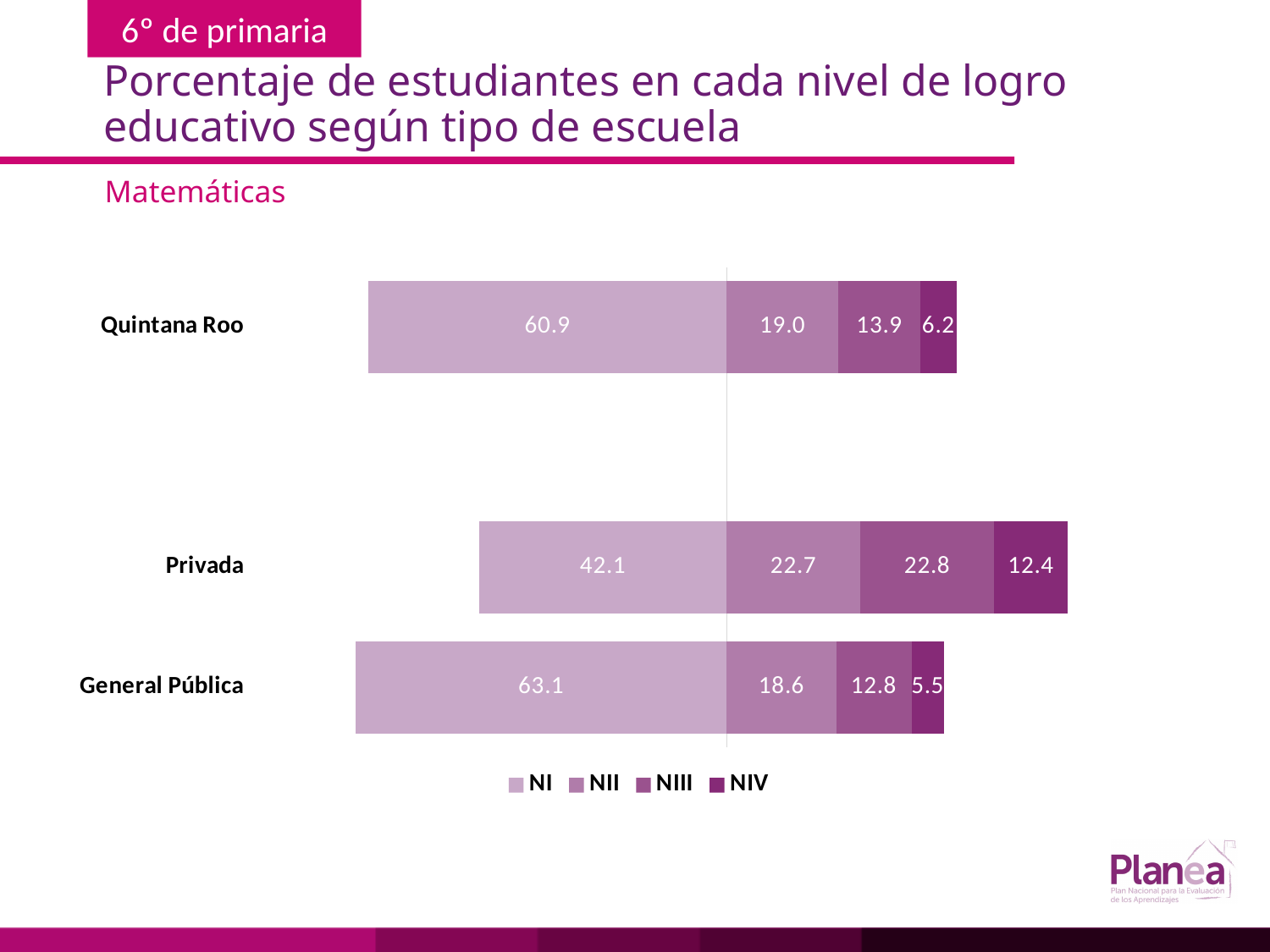
Which category has the highest NI value? General Pública What is the NI value for Quintana Roo? 60.9 How many categories are shown on the chart? 3 How many series does the legend list? 4 Which is larger, the NIII value for Quintana Roo or for General Pública? Quintana Roo What is the difference between the NI values for General Pública and Privada? 21.0 What is the NIV value for Privada? 12.4 What kind of chart is shown? Stacked bar chart What is the NIII value for Privada? 22.8 What is the total of the stacked bar for Privada? 100.0 What is the NII value for General Pública? 18.6 Which category has the lowest NIV value? General Pública